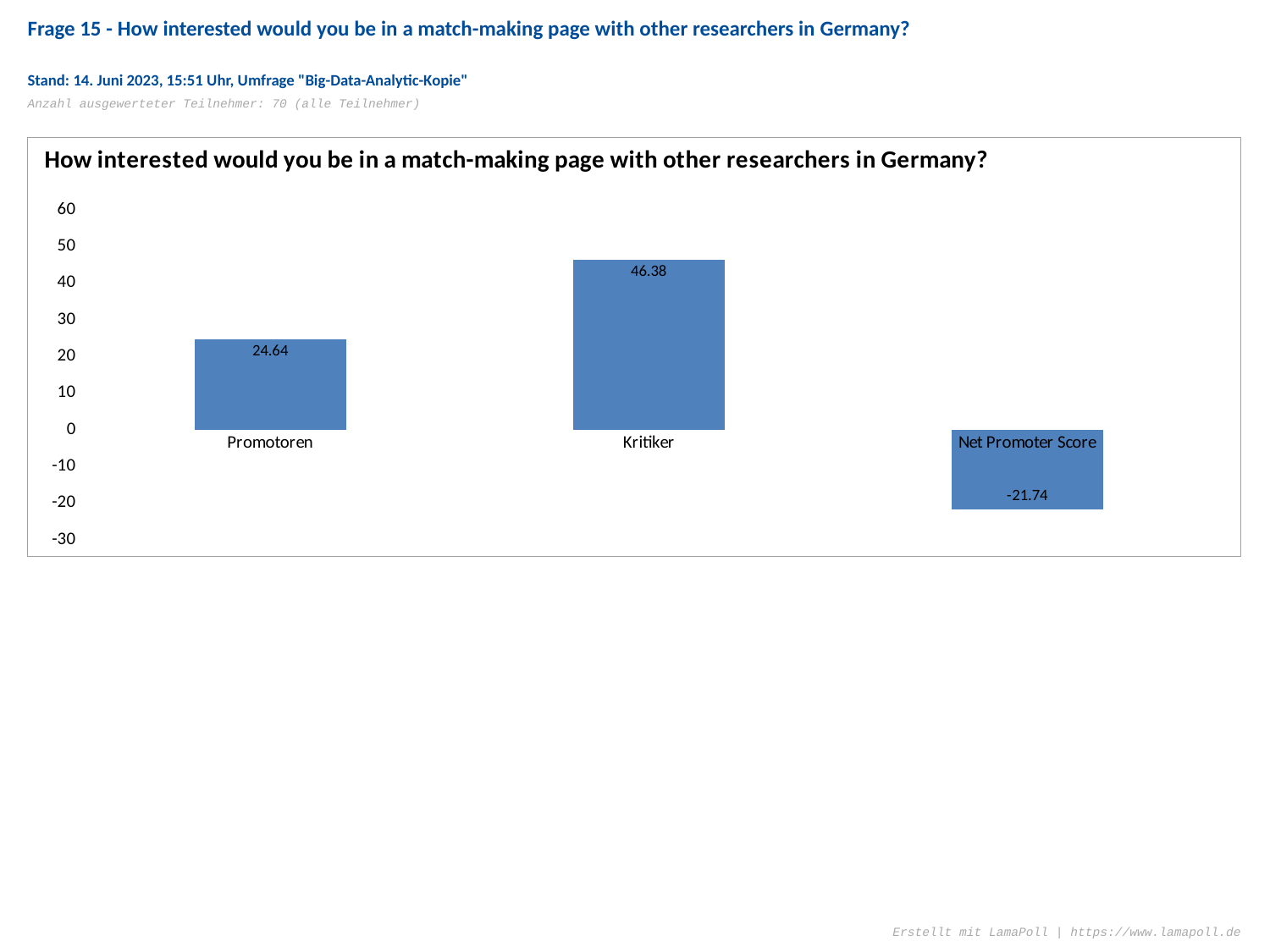
Which is larger, the value for Promotoren or the value for Kritiker? Kritiker Is the value for Net Promoter Score greater or less than 0? less What is the value for Net Promoter Score? -21.74 What is the title of the chart? How interested would you be in a match-making page with other researchers in Germany? How many categories are shown in the chart? 3 What is the value for Promotoren? 24.64 What is the value for Kritiker? 46.38 Which category has the highest value? Kritiker Is the value for Kritiker greater or less than 40? greater What kind of chart is shown? bar chart Which category has the lowest value? Net Promoter Score What is the difference between the values for Kritiker and Promotoren? 21.74